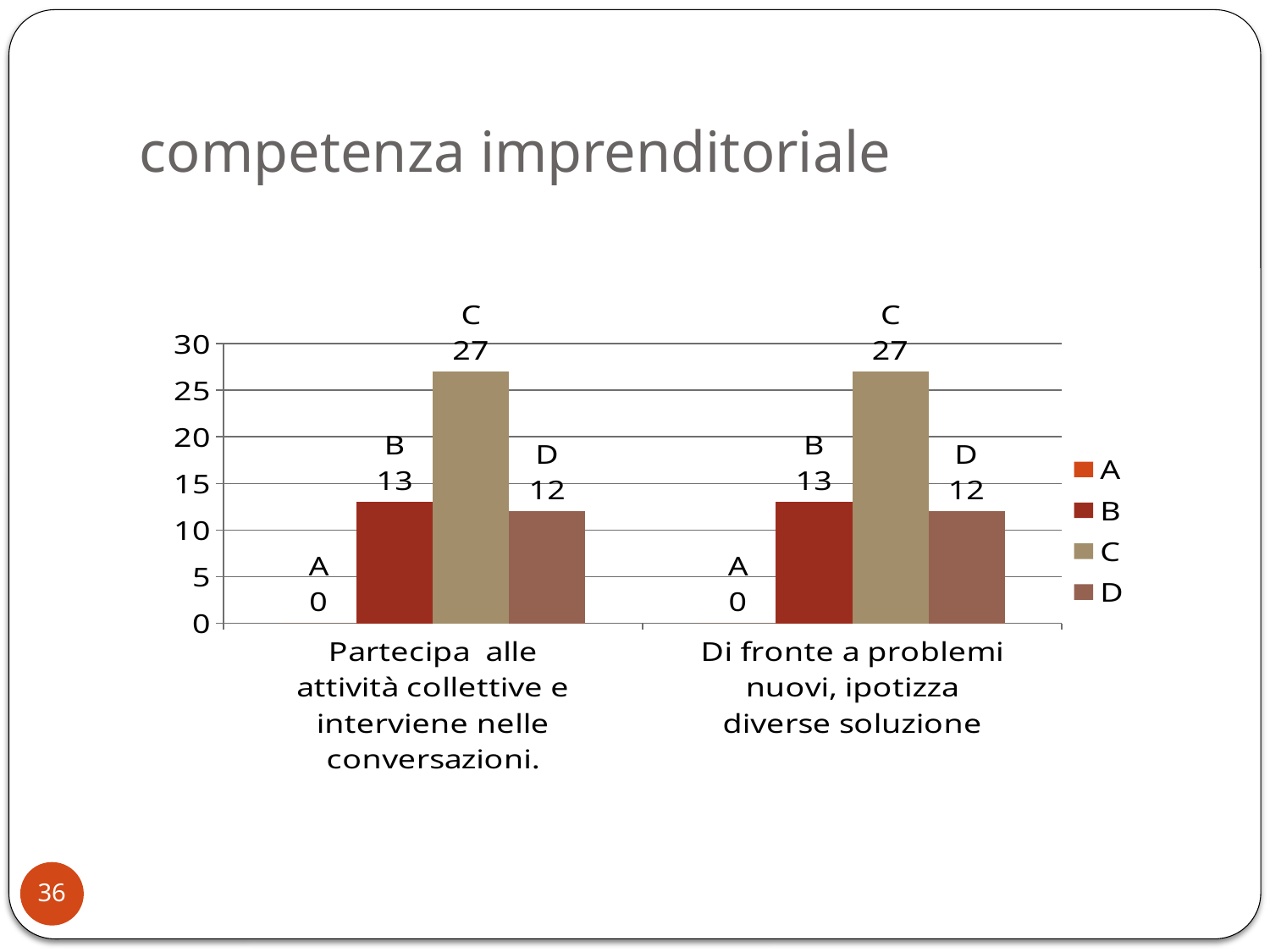
How many categories are shown on the x axis? 2 What is the value for series C in the category "Partecipa alle attività collettive e interviene nelle conversazioni."? 27 What is the title of the slide? competenza imprenditoriale What is the value for series B in the category "Di fronte a problemi nuovi, ipotizza diverse soluzione"? 13 What is the difference between the values for series C and series B in the category "Partecipa alle attività collettive e interviene nelle conversazioni."? 14 Which series has the lowest value in the category "Partecipa alle attività collettive e interviene nelle conversazioni."? A What is the value for series D in the category "Di fronte a problemi nuovi, ipotizza diverse soluzione"? 12 What kind of chart is shown on the slide? bar chart What is the value for series A in the category "Partecipa alle attività collettive e interviene nelle conversazioni."? 0 Which series has the highest value in the category "Di fronte a problemi nuovi, ipotizza diverse soluzione"? C How many series does the legend list? 4 Which is larger in the category "Di fronte a problemi nuovi, ipotizza diverse soluzione": the value for series B or series D? B